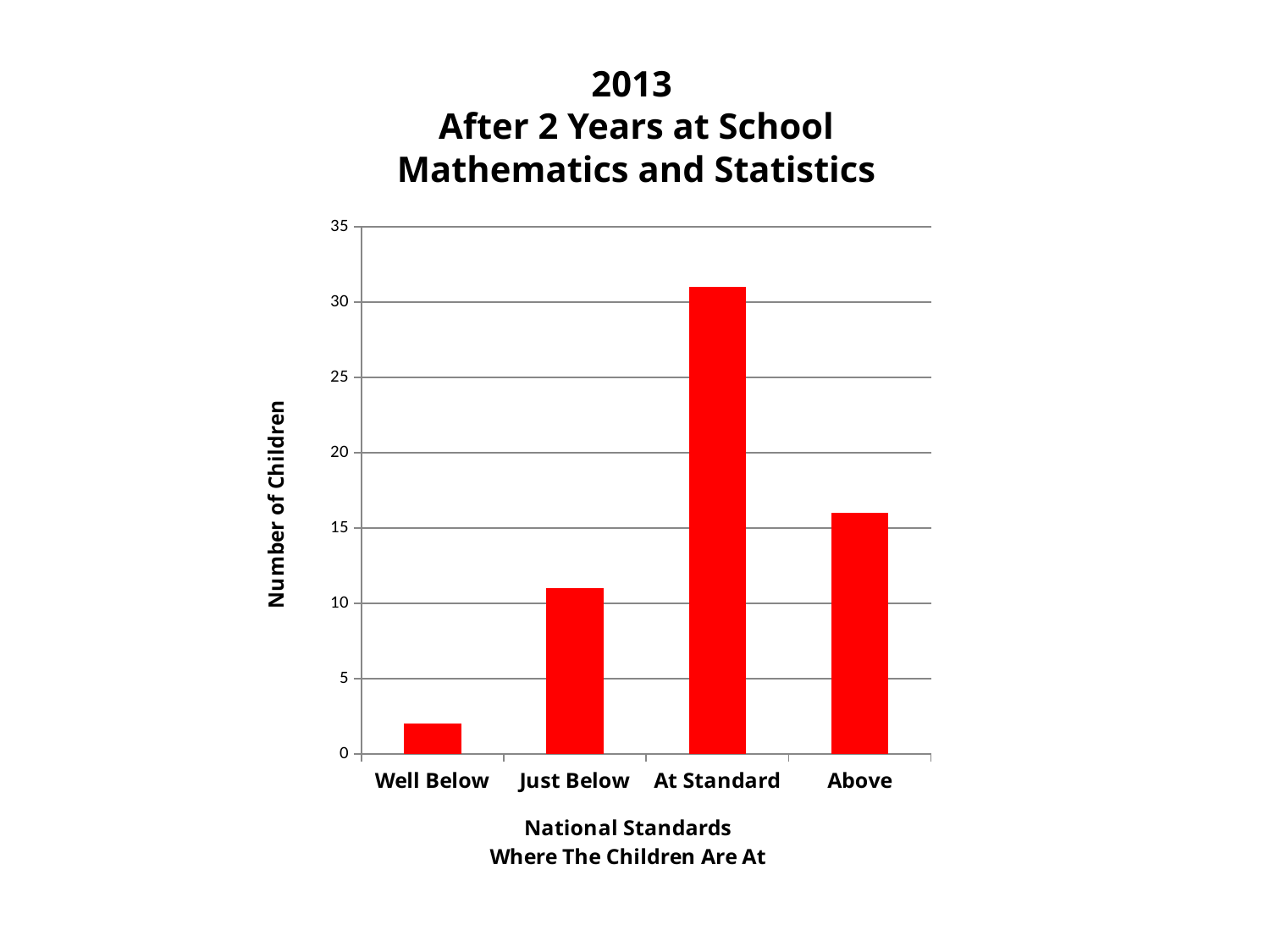
Which is larger, the value for Well Below or the value for At Standard? At Standard What is the label of the y axis? Number of Children Which is larger, the value for Above or the value for Just Below? Above Is the value for Just Below greater or less than 10? greater What kind of chart is shown on the slide? bar chart How many categories are shown on the x axis? 4 Which category has the highest number of children? At Standard Is the value for At Standard greater or less than 30? greater What colour are the bars in the chart? red Is the value for Above greater or less than 20? less Which category has the lowest number of children? Well Below